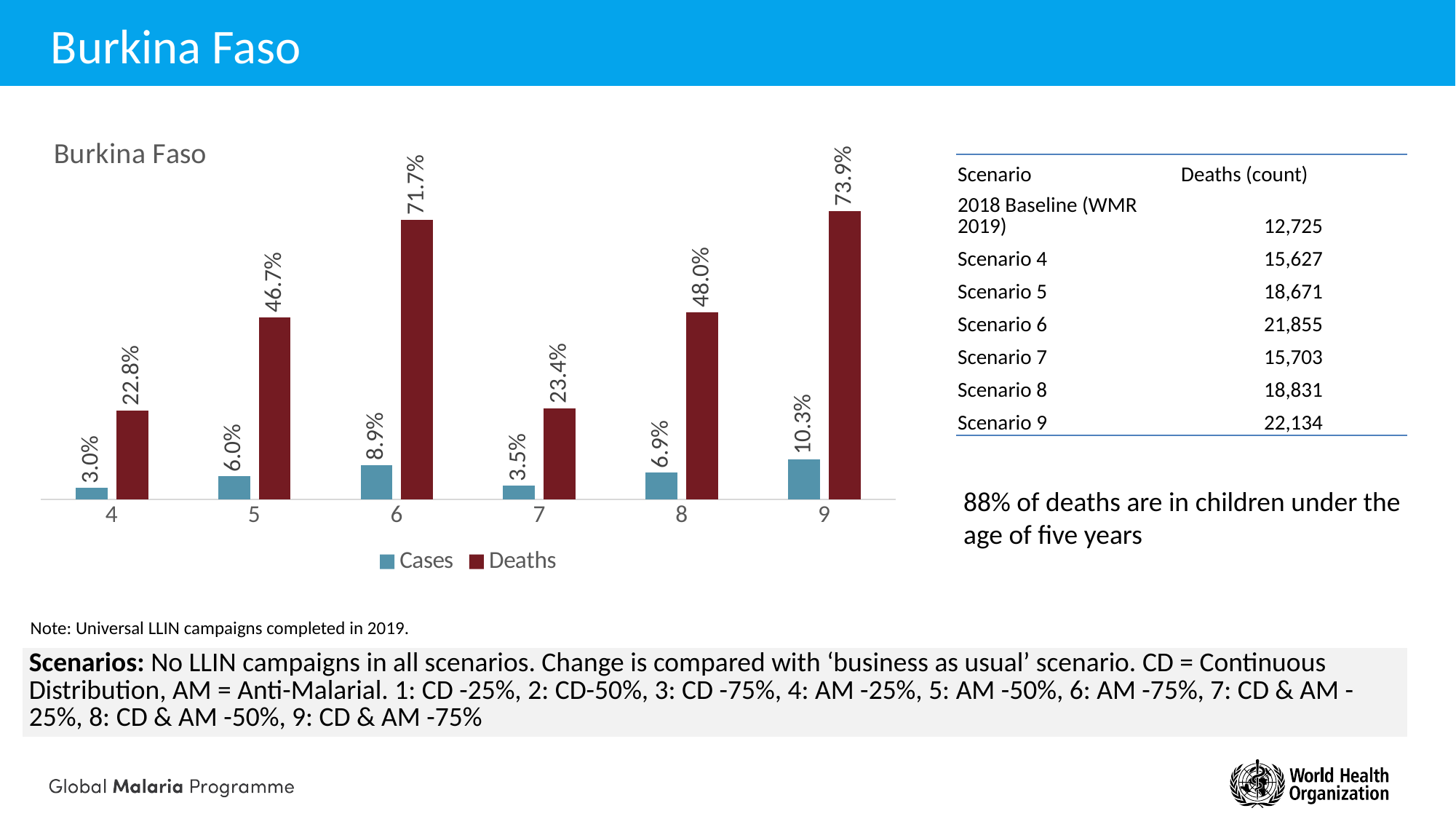
Which scenario has the highest Deaths value? 9 What is the difference between the Deaths values for scenario 9 and scenario 6? 2.2% Which scenario has the lowest Cases value? 4 What is the Cases value for scenario 4? 3.0% What are the two series named in the chart legend? Cases and Deaths What is the Deaths value for scenario 8? 48.0% How many scenarios are shown on the x axis of the chart? 6 Which is larger, the Deaths value for scenario 5 or for scenario 8? Scenario 8 How many series does the chart legend list? 2 What is the Cases value for scenario 9? 10.3% What is the Deaths value for scenario 6? 71.7% What kind of chart is shown on the slide? Bar chart